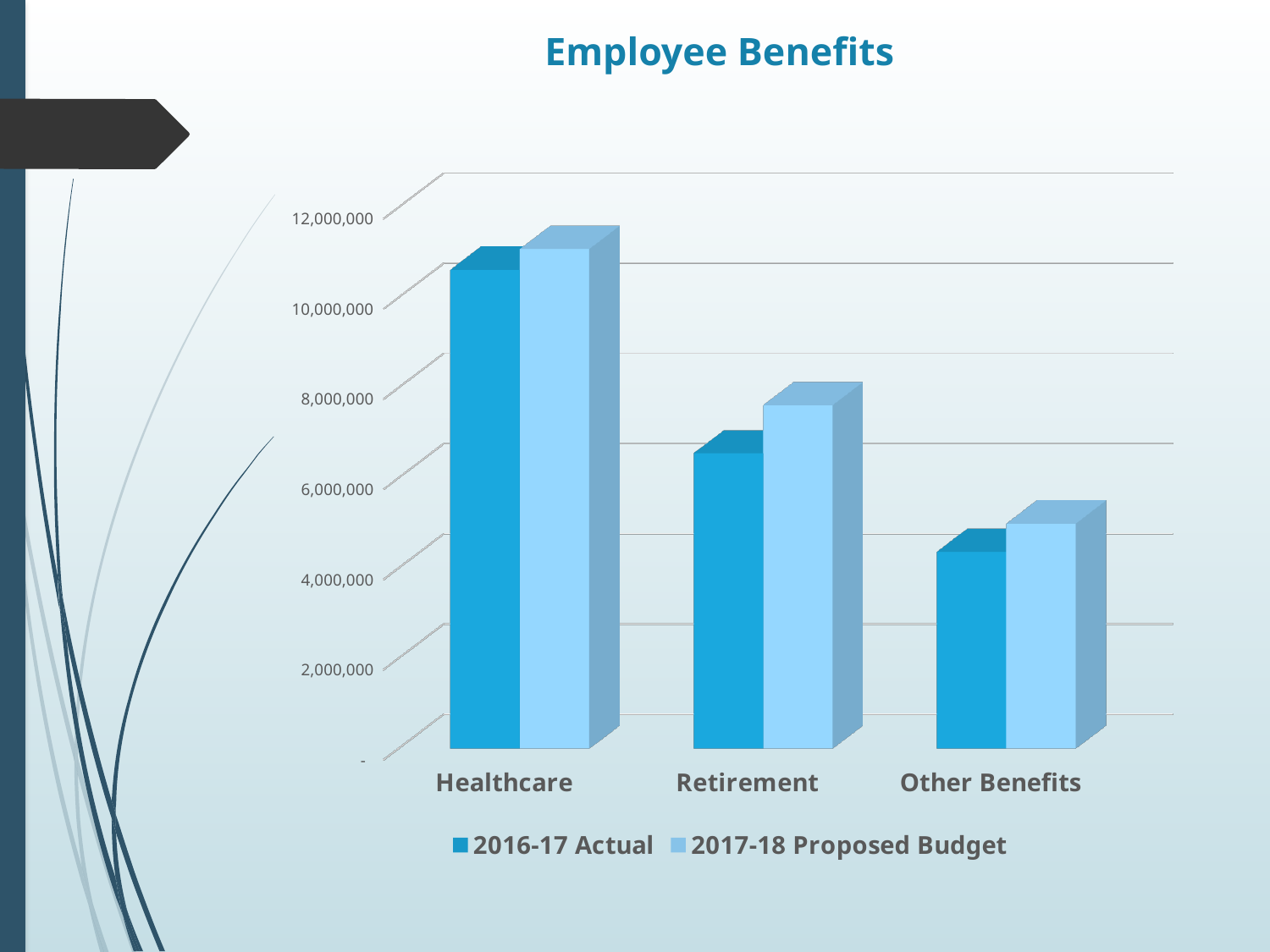
Is the 2016-17 Actual value for Healthcare greater or less than 10,000,000? greater Which category has the highest 2016-17 Actual value? Healthcare For Retirement, which is larger: the 2016-17 Actual or the 2017-18 Proposed Budget? 2017-18 Proposed Budget Which series is shown in the lighter blue colour in the legend? 2017-18 Proposed Budget What kind of chart is shown on the slide? Bar chart Is the 2017-18 Proposed Budget value for Retirement greater or less than 8,000,000? less What is the title of the chart? Employee Benefits Which category has the lowest 2017-18 Proposed Budget value? Other Benefits Is the 2016-17 Actual value for Other Benefits greater or less than 4,000,000? greater Do the 2017-18 Proposed Budget values rise or fall from Healthcare to Other Benefits? fall How many series does the legend list? 2 How many categories are shown on the x axis? 3